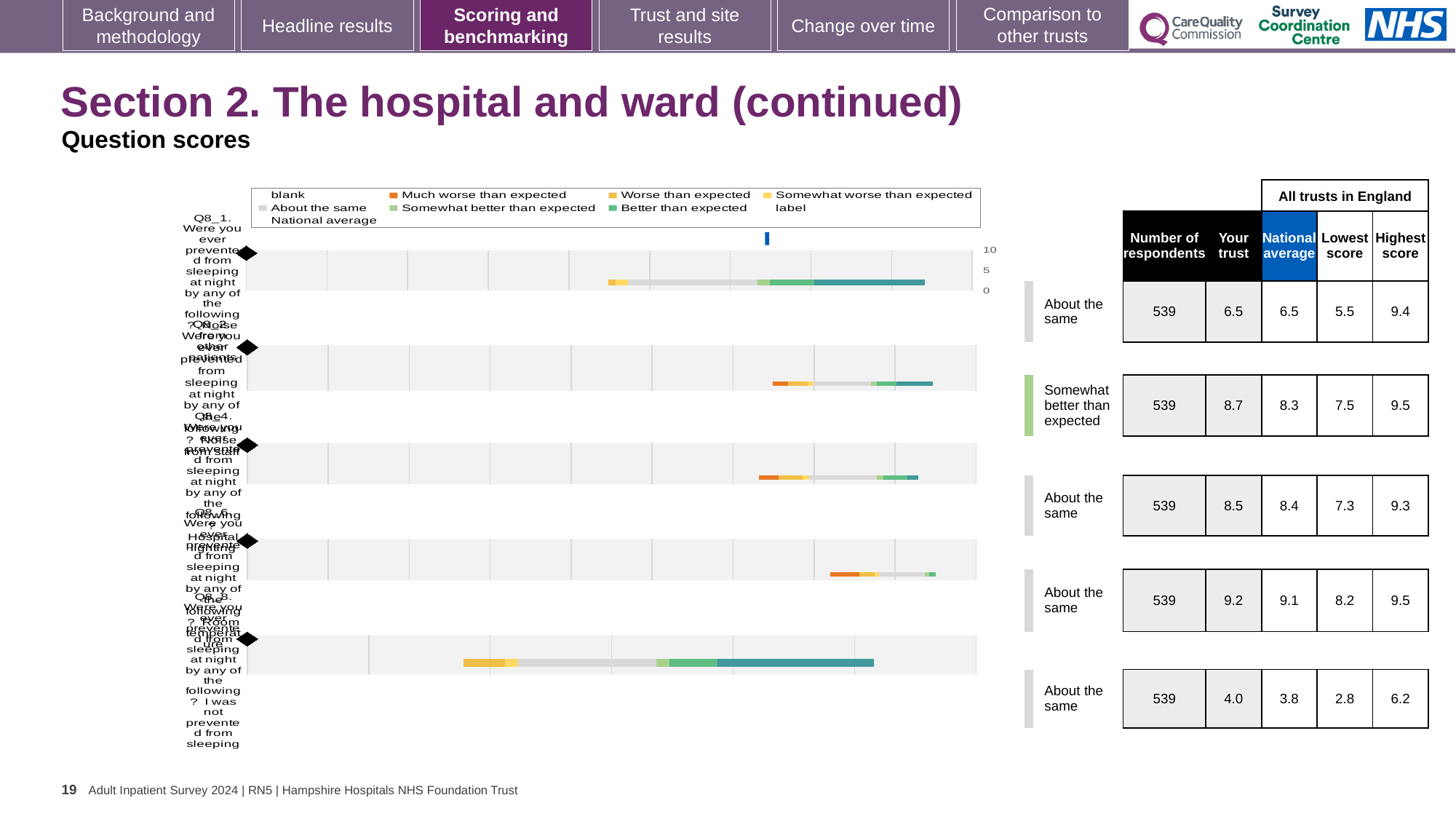
In the table, what is the national average for the second row (Q8_2)? 8.3 How many question rows are plotted in the chart? 5 Which row has the lowest 'Your trust' score in the table? Q8_8 (fifth row), 4.0 In the table, what is the 'Your trust' score for the top row (Q8_1)? 6.5 How many respondents are listed for each question in the table? 539 For the third row (Q8_4), which is larger: the 'Your trust' score or the national average? Your trust (8.5) Which row is rated 'Somewhat better than expected'? Q8_2 (second row) What is the lowest score across all trusts in England for the fourth row (Q8_6)? 8.2 For the second row (Q8_2), how much higher is the 'Your trust' score than the national average? 0.4 Which row has the highest 'Your trust' score in the table? Q8_6 (fourth row), 9.2 What kind of chart is shown on the slide? bar chart What is the highest score across all trusts in England for the bottom row (Q8_8)? 6.2